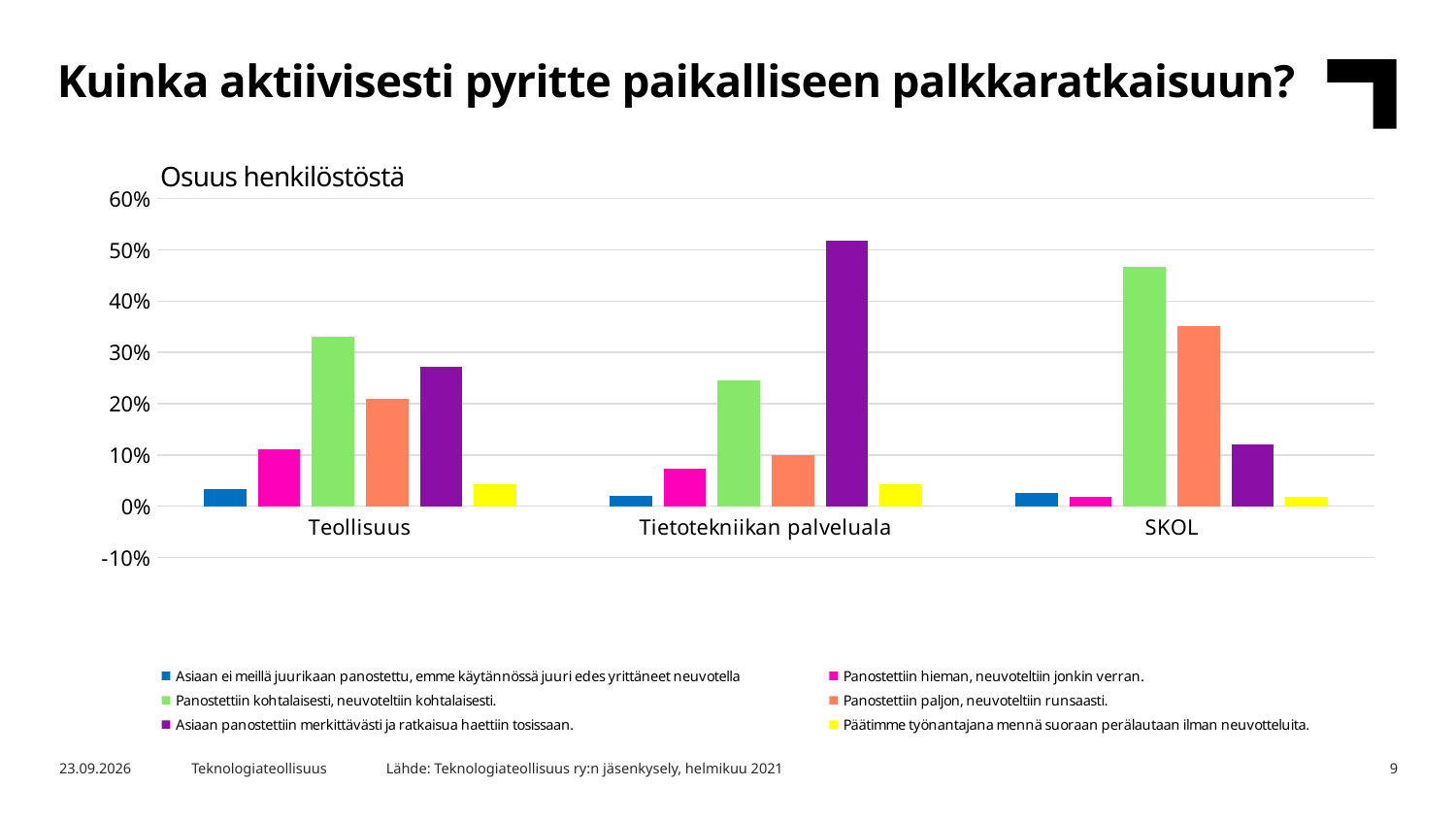
What is the label shown above the vertical axis of the chart? Osuus henkilöstöstä Which series has the highest value in the SKOL category? Panostettiin kohtalaisesti, neuvoteltiin kohtalaisesti. For the series 'Panostettiin paljon, neuvoteltiin runsaasti.', which category has the larger value: SKOL or Teollisuus? SKOL Which series has the highest value in the Teollisuus category? Panostettiin kohtalaisesti, neuvoteltiin kohtalaisesti. Is the value for 'Asiaan panostettiin merkittävästi ja ratkaisua haettiin tosissaan.' in Tietotekniikan palveluala greater or less than 40%? greater For the series 'Panostettiin kohtalaisesti, neuvoteltiin kohtalaisesti.', which category has the larger value: Teollisuus or Tietotekniikan palveluala? Teollisuus Is the value for 'Panostettiin paljon, neuvoteltiin runsaasti.' in Teollisuus greater or less than 30%? less What kind of chart is shown on the slide? bar chart Which series has the highest value in the Tietotekniikan palveluala category? Asiaan panostettiin merkittävästi ja ratkaisua haettiin tosissaan. Is the value for 'Panostettiin kohtalaisesti, neuvoteltiin kohtalaisesti.' in SKOL greater or less than 40%? greater How many categories are shown on the x axis of the chart? 3 How many series does the chart legend list? 6